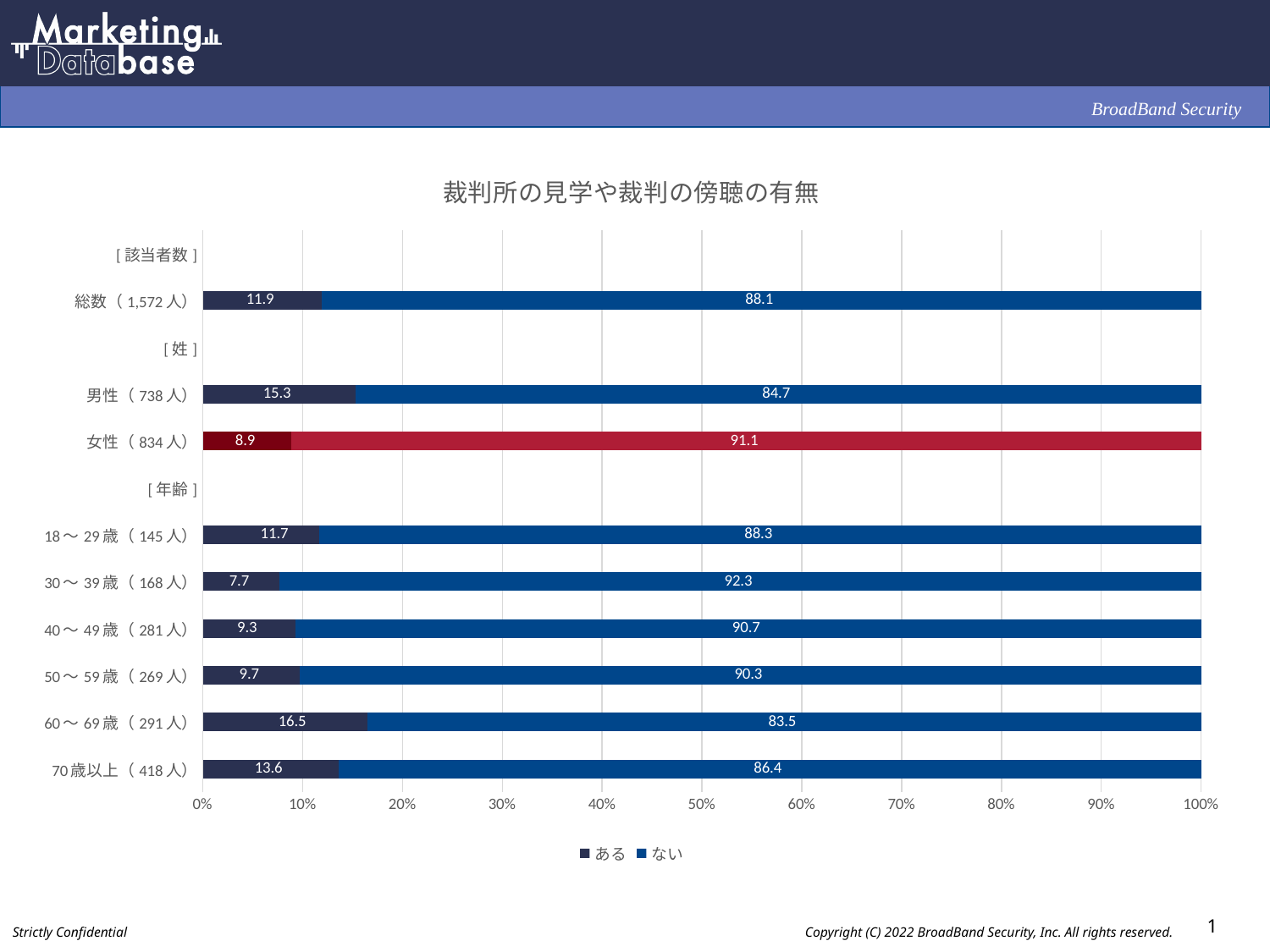
What is the value of ある for 総数 (1,572人)? 11.9 What is the title of the chart? 裁判所の見学や裁判の傍聴の有無 How many categories have bars plotted in the chart? 9 What is the total of the stacked bar for 40～49歳 (281人)? 100 What is the value of ない for 女性 (834人)? 91.1 Which category has the highest value for ある? 60～69歳 (291人) What kind of chart is shown on the slide? Stacked bar chart How many series does the legend list? 2 Which category has the lowest value for ある? 30～39歳 (168人) What is the difference between the ある values for 男性 (738人) and 女性 (834人)? 6.4 Which is larger, the ある value for 70歳以上 (418人) or for 18～29歳 (145人)? 70歳以上 (418人) What is the value of ある for 60～69歳 (291人)? 16.5